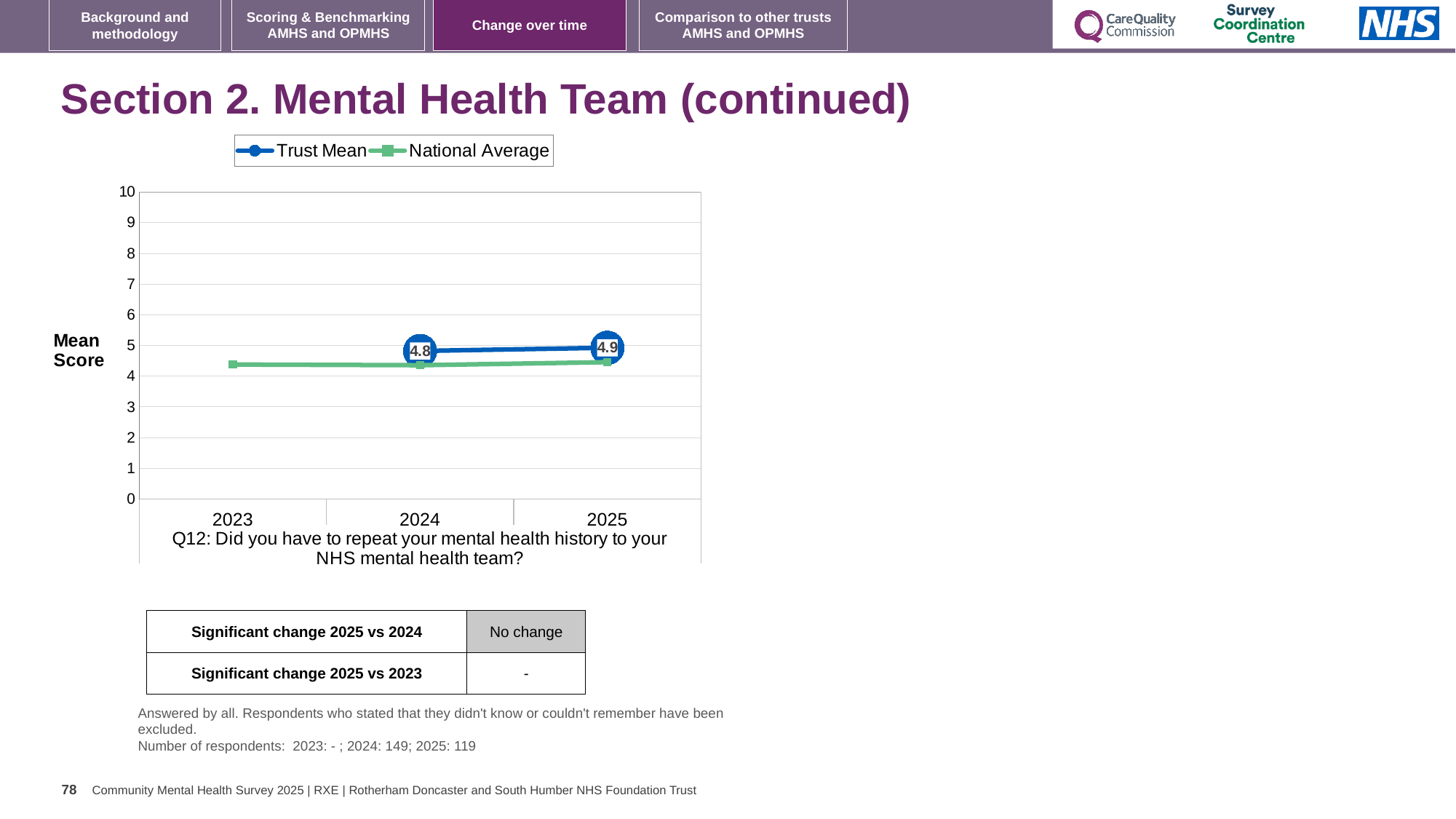
Is the National Average value for 2025 greater or less than 4? greater What are the two series named in the legend? Trust Mean and National Average How many series does the legend list? 2 How many years are shown on the x axis? 3 Which year has the higher Trust Mean, 2024 or 2025? 2025 In 2025, which series has the higher value, Trust Mean or National Average? Trust Mean What is the difference between the Trust Mean in 2025 and in 2024? 0.1 Is the National Average value for 2023 greater or less than 5? less Does the Trust Mean rise or fall from 2024 to 2025? rise What is the Trust Mean value for 2025? 4.9 What kind of chart is shown on the slide? line chart What is the Trust Mean value for 2024? 4.8